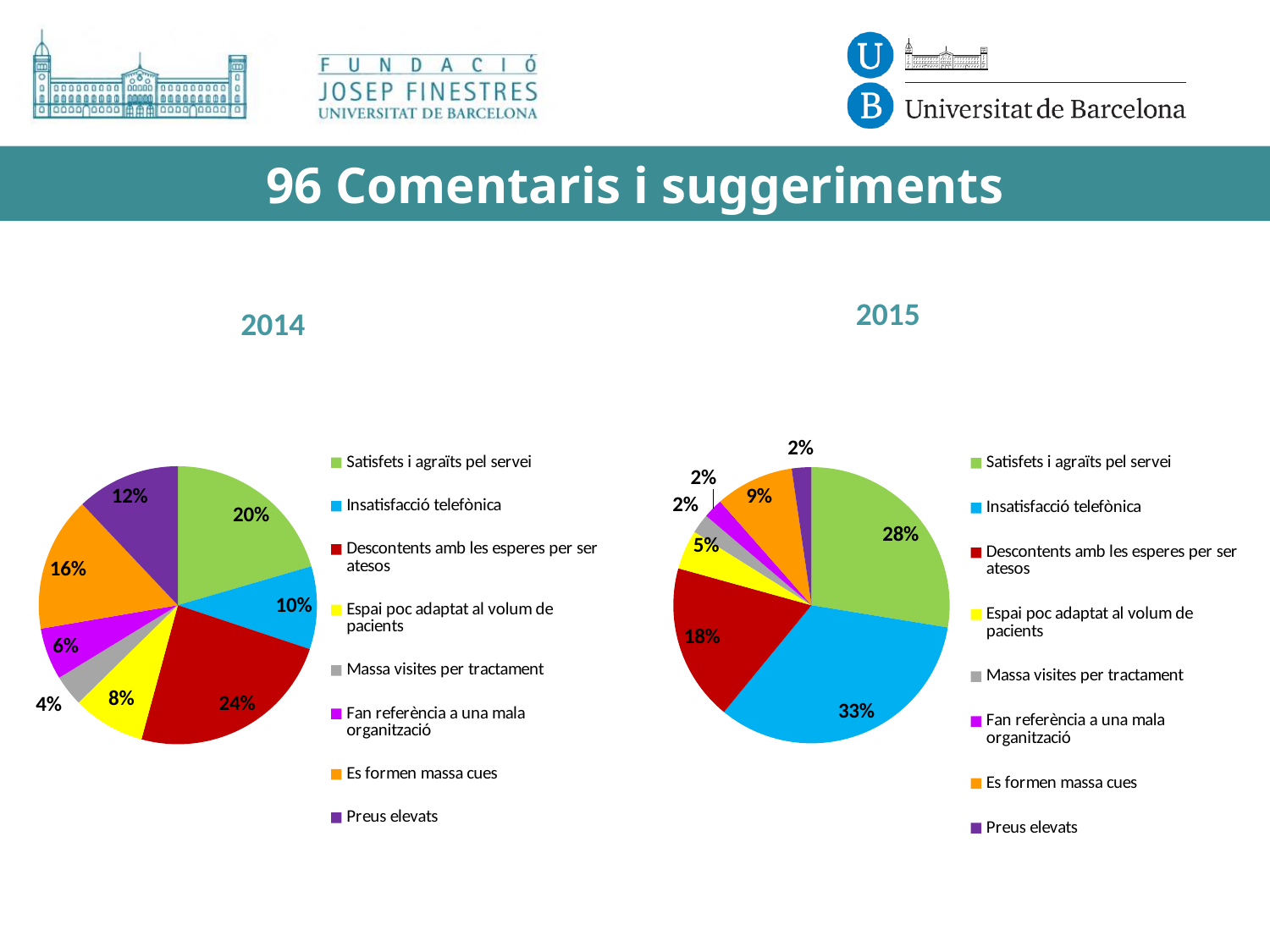
In the 2015 pie chart, what share is labelled for 'Satisfets i agraïts pel servei'? 28% What is the difference between the 'Insatisfacció telefònica' share in 2015 and in 2014? 23 percentage points How many slices does the 2014 pie chart have? 8 In the 2015 pie chart, which is larger: 'Es formen massa cues' or 'Espai poc adaptat al volum de pacients'? Es formen massa cues In the 2014 pie chart, which category has the smallest slice? Massa visites per tractament What type of chart is used for the 2015 data? Pie chart In the 2015 pie chart, what colour is the slice for 'Preus elevats'? Purple In the 2014 pie chart, what share is labelled for 'Es formen massa cues'? 16% In the 2015 pie chart, what share is labelled for 'Insatisfacció telefònica'? 33% In the 2014 pie chart, which category has the largest slice? Descontents amb les esperes per ser atesos In the 2015 pie chart, which category has the largest slice? Insatisfacció telefònica In the 2014 pie chart, what share is labelled for 'Descontents amb les esperes per ser atesos'? 24%